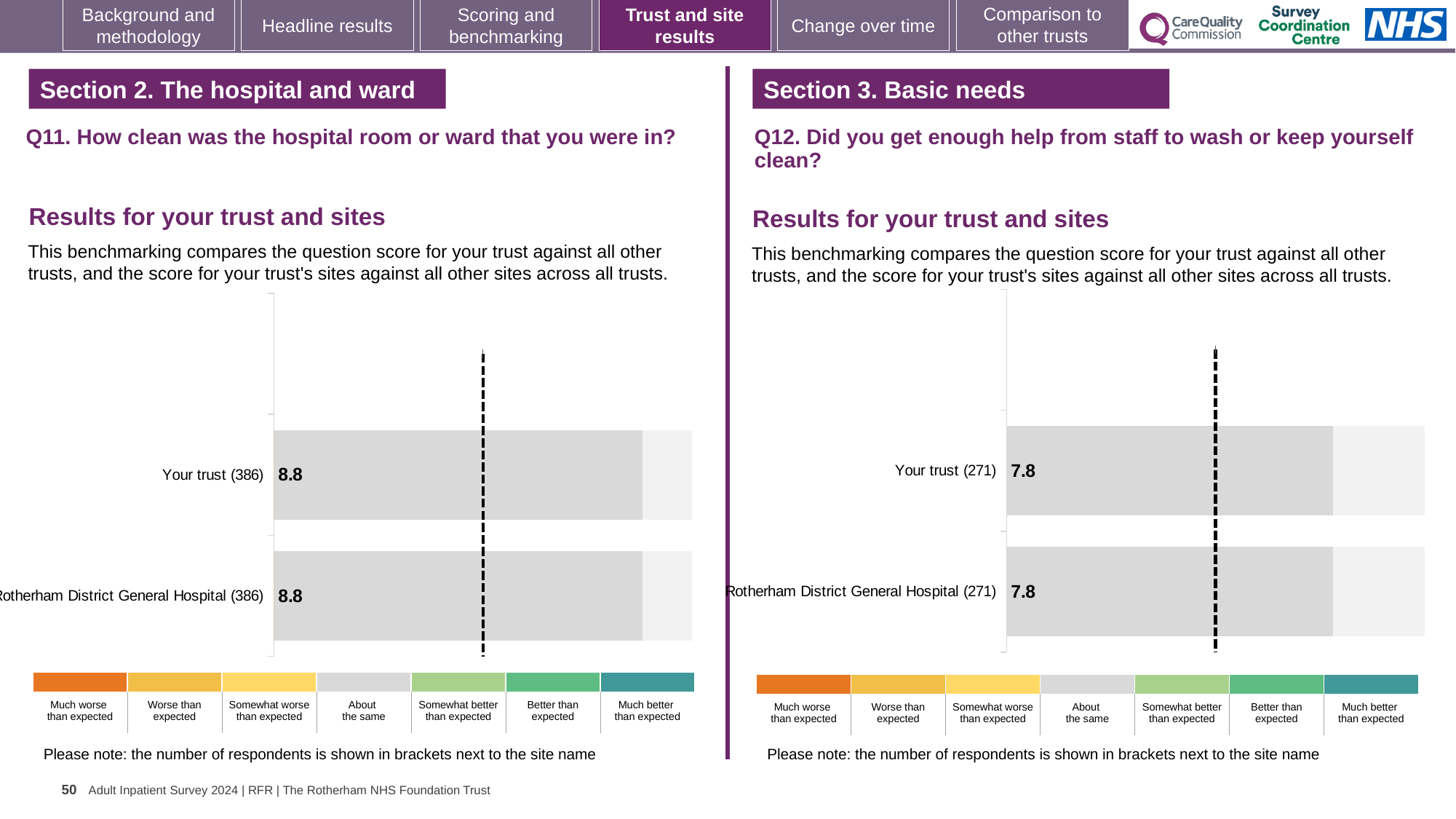
How many bars are plotted in the Q12 chart on the right? 2 In the Q12 chart on the right, what is the difference between the score for Your trust and the score for Rotherham District General Hospital? 0 In the Q11 chart on the left, how many respondents are shown in brackets next to Your trust? 386 In the Q12 chart on the right, how many respondents are shown in brackets next to Rotherham District General Hospital? 271 In the Q12 chart on the right, what is the score for Your trust? 7.8 Is the score for Your trust in the Q12 chart on the right larger or smaller than the score for Your trust in the Q11 chart on the left? Smaller How many bars are plotted in the Q11 chart on the left? 2 In the Q12 chart on the right, what is the score for Rotherham District General Hospital? 7.8 In the Q11 chart on the left, what is the score for Rotherham District General Hospital? 8.8 In the Q11 chart on the left, what is the score for Your trust? 8.8 In the Q11 chart on the left, what is the difference between the score for Your trust and the score for Rotherham District General Hospital? 0 What kind of chart is used for the Q11 results on the left? Bar chart